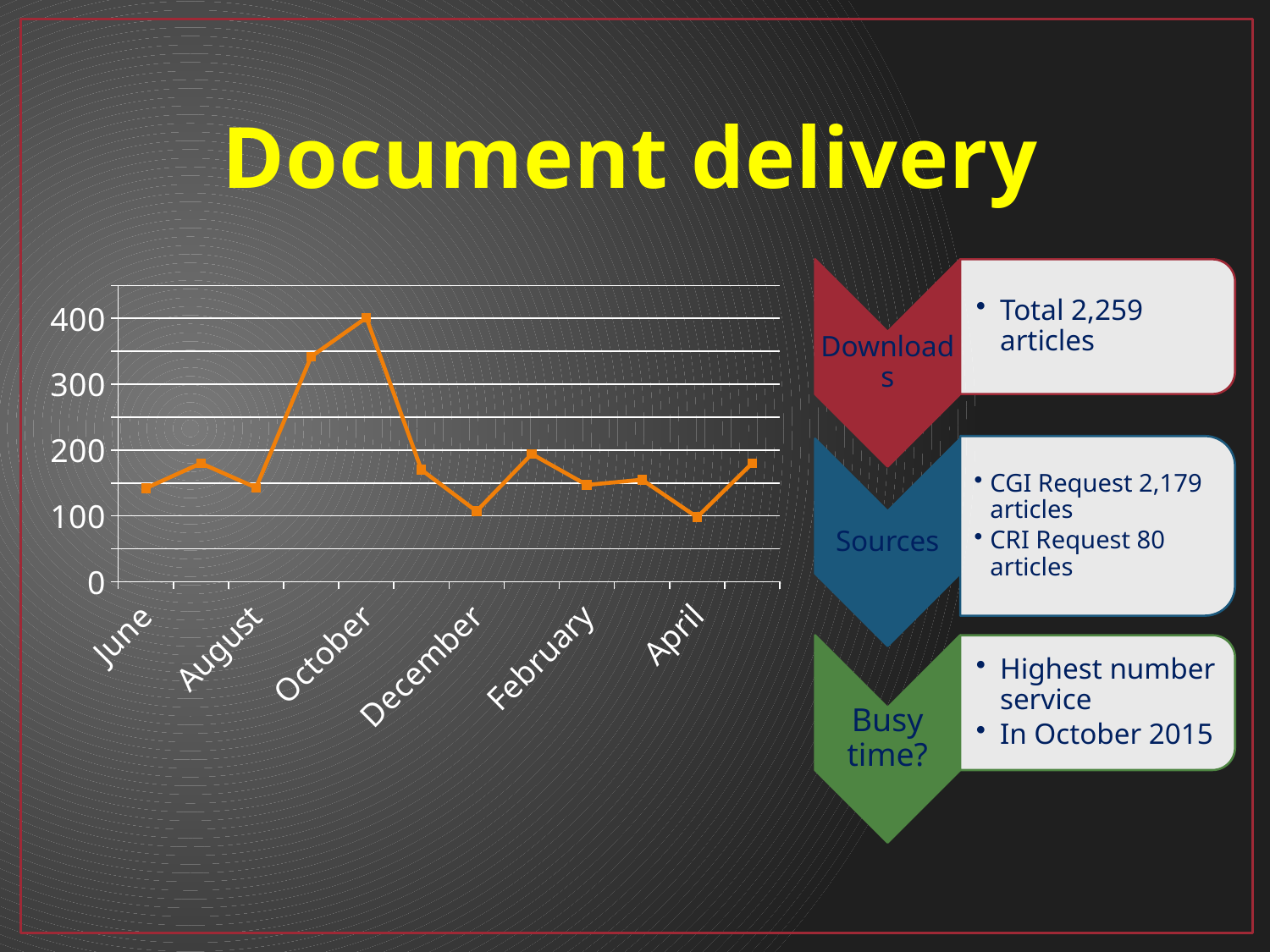
Do the values rise or fall from August to October? rise Is the value for October greater or less than 300? greater Is the value for June greater or less than 200? less Which is larger, the value for October or the value for June? October Is the value for August greater or less than 100? greater What colour is the line in the chart? orange Which month has the highest value on the line chart? October Which is larger, the value for August or the value for October? October What kind of chart is shown on the slide? line chart Do the values rise or fall from October to December? fall